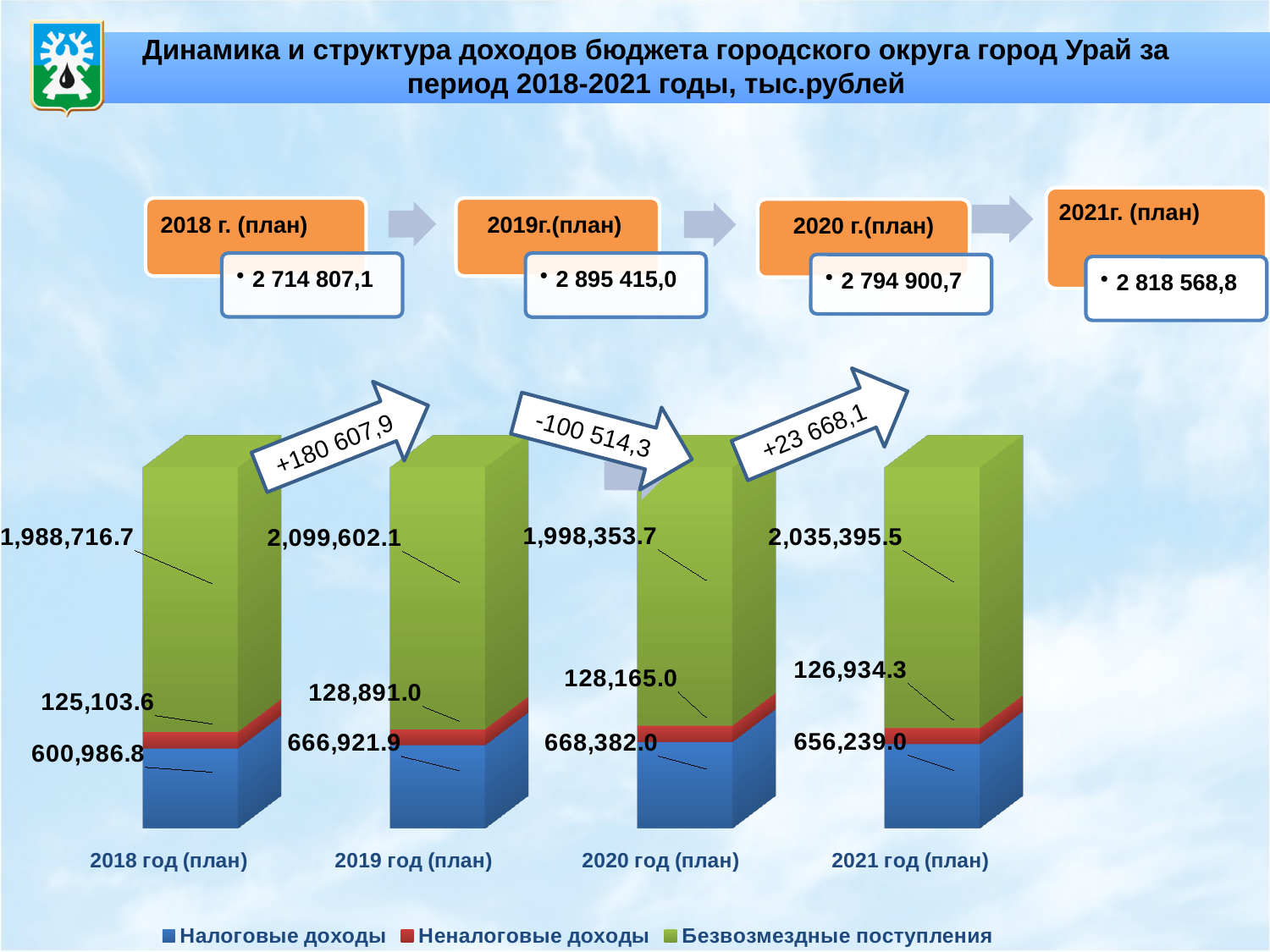
Which colour represents Неналоговые доходы in the legend? Red In which year is Безвозмездные поступления highest? 2019 год (план) How many series does the legend list? 3 What is the value of Налоговые доходы for 2018 год (план)? 600,986.8 What is the value of Неналоговые доходы for 2021 год (план)? 126,934.3 What kind of chart is shown on the slide? Stacked bar chart Which is larger: Налоговые доходы in 2020 год (план) or in 2021 год (план)? 2020 год (план) What is the difference in Безвозмездные поступления between 2019 год (план) and 2018 год (план)? 110,885.4 In which year is Налоговые доходы lowest? 2018 год (план) What is the total of the stacked bar for 2019 год (план)? 2,895,415.0 How many categories (years) are shown on the x axis? 4 What is the value of Безвозмездные поступления for 2020 год (план)? 1,998,353.7